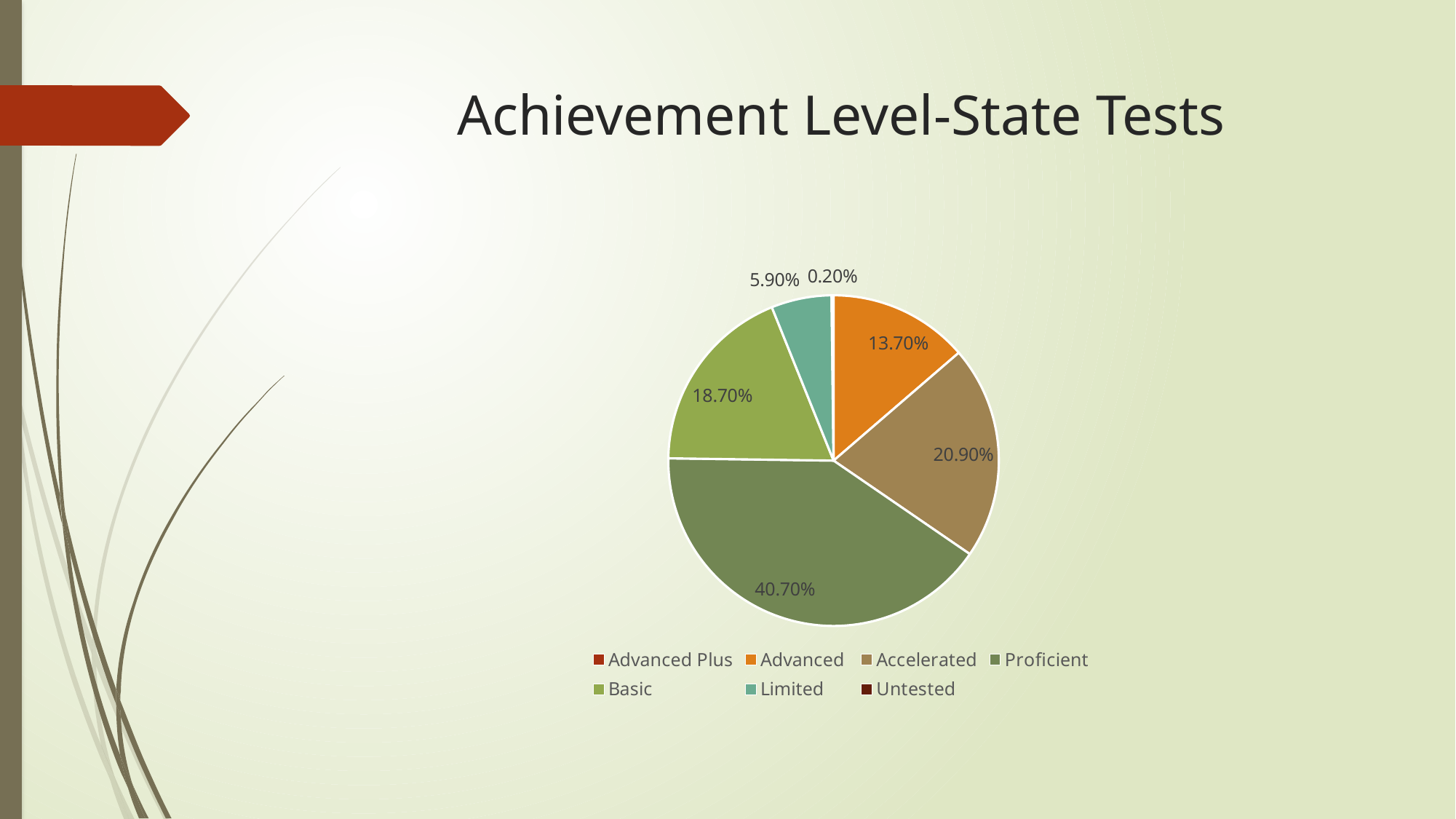
What percentage is shown for the Accelerated slice? 20.90% What percentage is shown for the Basic slice? 18.70% Which achievement level has the largest slice of the pie? Proficient Which slice is larger, Basic or Advanced? Basic What percentage is shown for the Limited slice? 5.90% What type of chart is shown on the slide? Pie chart What is the difference between the Proficient and Basic percentages? 22.00% What percentage is shown for the Proficient slice? 40.70% Which slice with a printed label is the smallest? Untested What is the title of the chart? Achievement Level-State Tests What percentage is shown for the Advanced slice? 13.70% How many entries does the legend list? 7